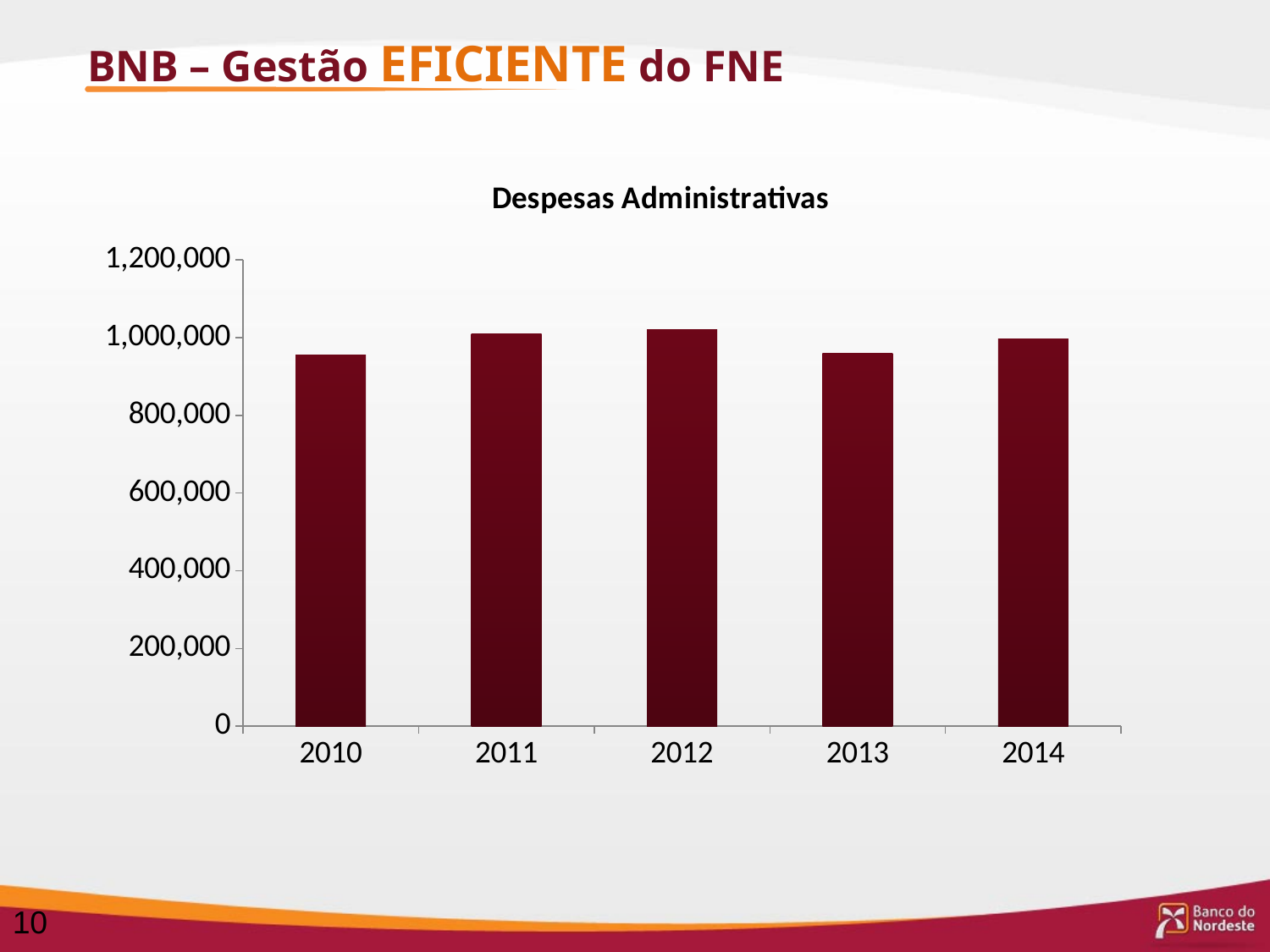
How many years are shown on the x axis of the chart? 5 Is the value for 2014 greater or less than 800,000? greater Which is larger, the value for 2011 or the value for 2013? 2011 Is the value for 2010 greater or less than 1,000,000? less What is the first year shown on the x axis of the chart? 2010 Is the value for 2010 greater or less than 800,000? greater What is the title of the chart? Despesas Administrativas Which is larger, the value for 2014 or the value for 2013? 2014 Which is larger, the value for 2012 or the value for 2010? 2012 What type of chart is shown on the slide? bar chart